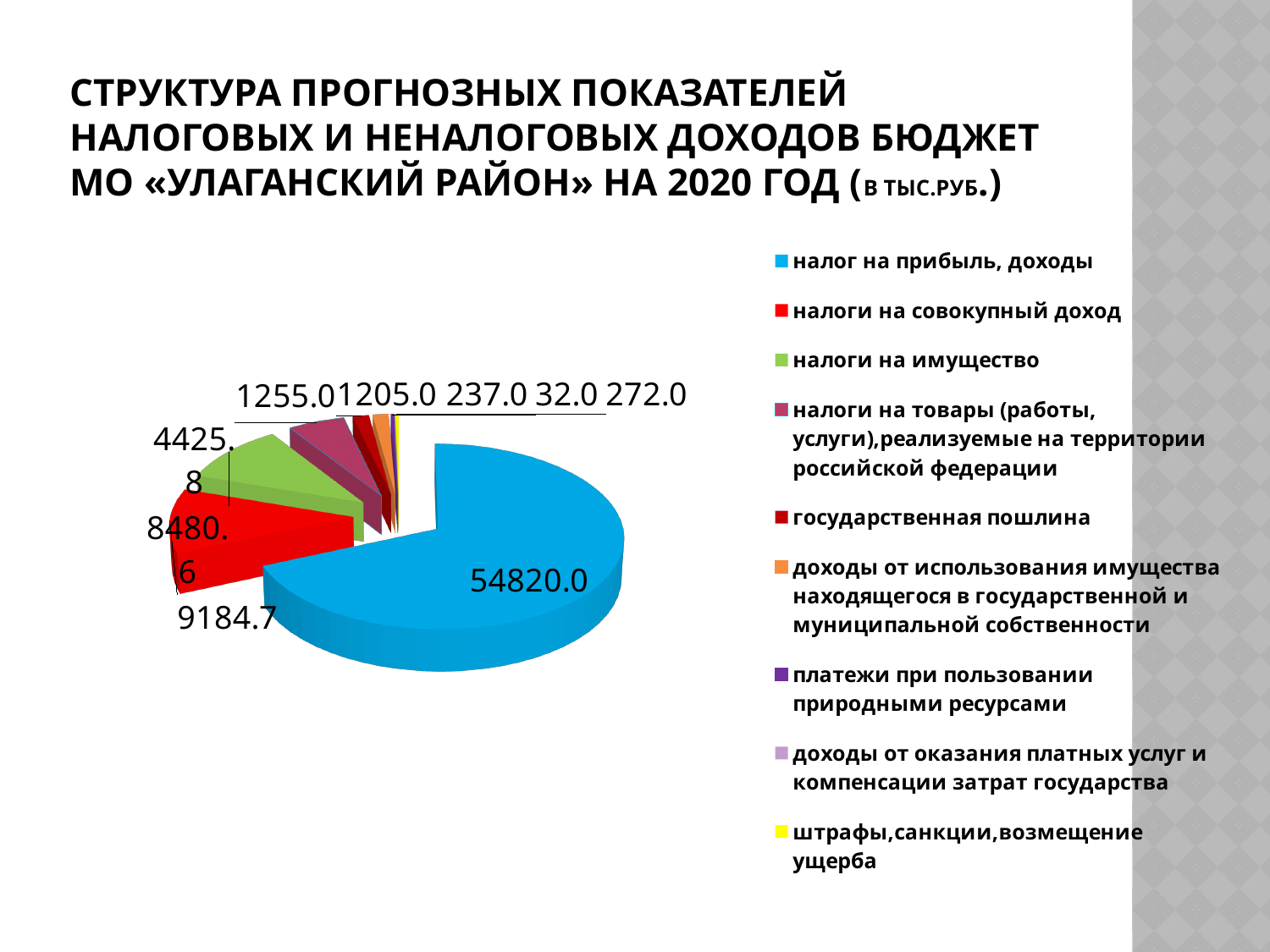
What is the smallest value labelled on the pie chart? 32.0 What is the value shown for налог на прибыль, доходы? 54820.0 Which category has the largest slice in the pie chart? налог на прибыль, доходы What is the difference between the largest labelled value (54820.0) and the second largest (9184.7)? 45635.3 How many categories does the legend of the pie chart list? 9 Which is larger: the slice for налог на прибыль, доходы or the slice for налоги на совокупный доход? налог на прибыль, доходы What is the value shown for штрафы,санкции,возмещение ущерба? 272.0 Which category has the smallest slice in the pie chart? доходы от оказания платных услуг и компенсации затрат государства What kind of chart is shown on the slide? pie chart What is the largest value labelled on the pie chart? 54820.0 In what units are the values on the chart given, according to the slide title? тыс.руб. What colour is the slice for налог на прибыль, доходы? blue